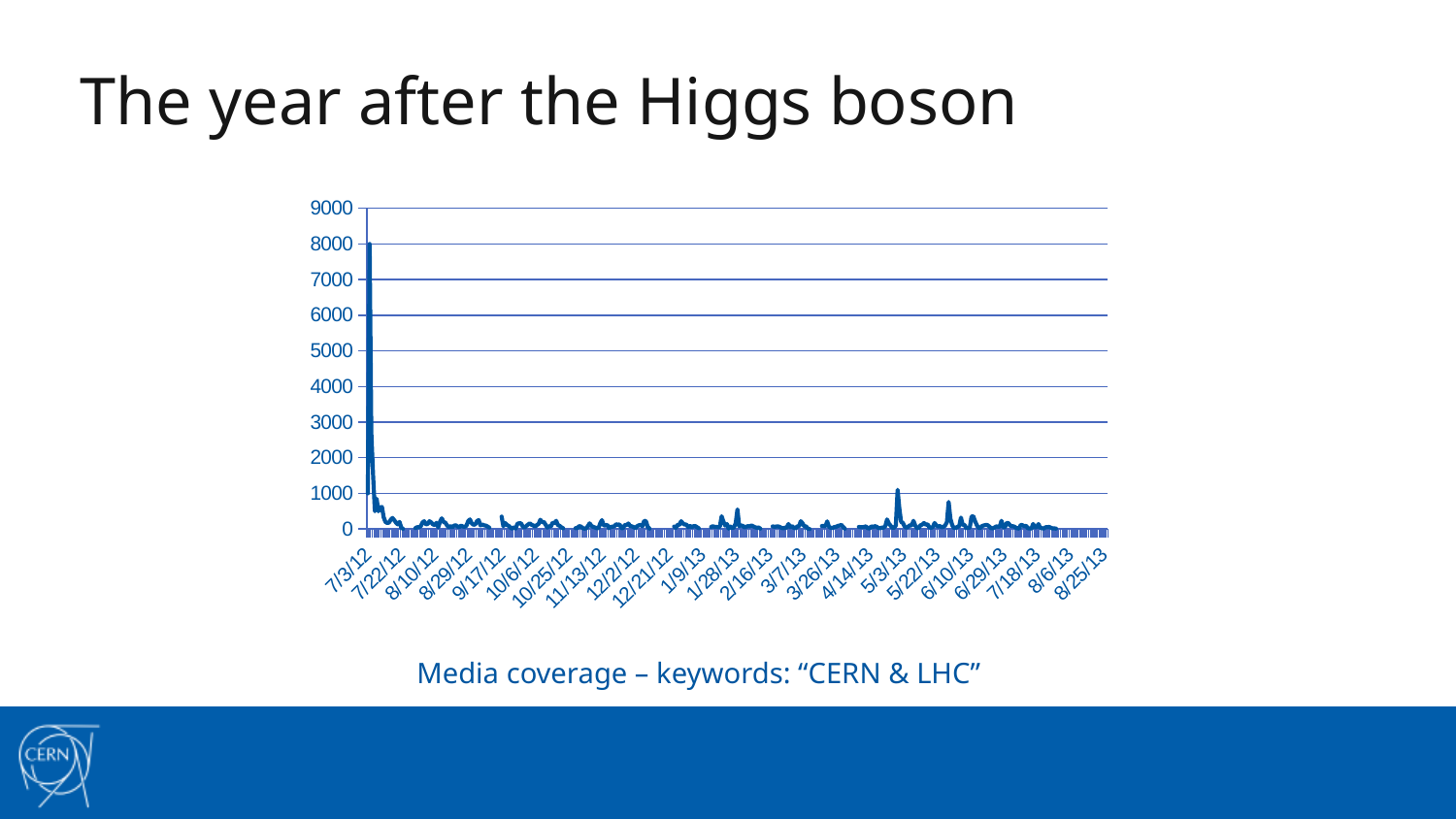
What caption is shown below the chart? Media coverage – keywords: "CERN & LHC" Around which date does the media coverage reach its highest value? 7/3/12 What kind of chart is shown on the slide? line chart How many date labels are shown along the x axis? 23 Is the peak value at 7/3/12 greater or less than 5000? greater Overall, do the values rise or fall from the start of the x axis to the end? fall Which has the larger value: the point at 7/3/12 or the spike near 5/3/13? 7/3/12 What is the highest value shown on the y axis? 9000 Is the spike near 5/3/13 greater or less than 2000? less